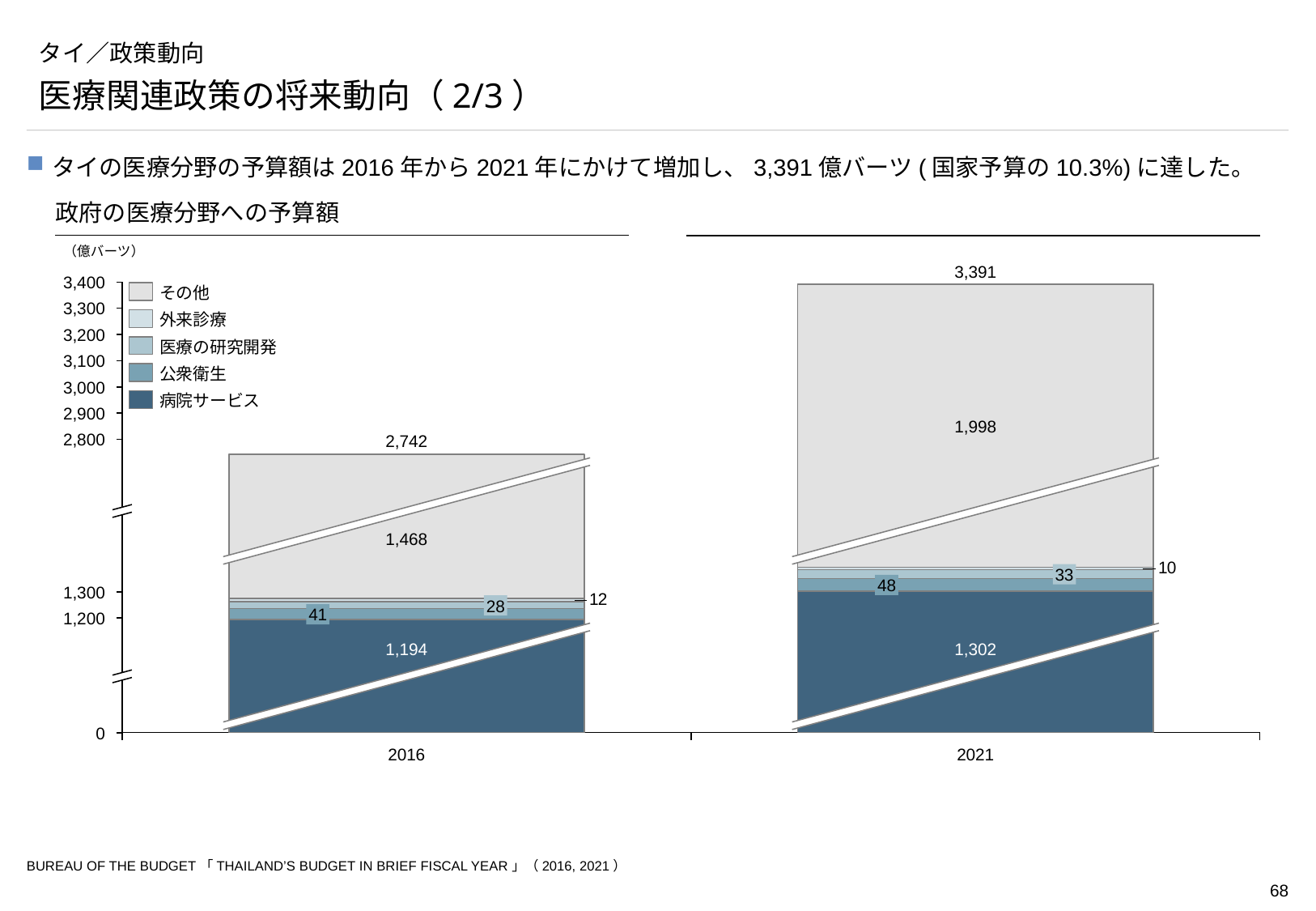
What kind of chart is shown on the slide? Stacked bar chart How many series does the legend list? 5 What is the difference between the 病院サービス values for 2021 and 2016? 108 Which year has the larger value for その他, 2016 or 2021? 2021 What is the value of 外来診療 in 2016? 12 What is the total value of the 2021 bar? 3,391 What is the value of 病院サービス in 2016? 1,194 What is the value of その他 in 2021? 1,998 What is the value of 公衆衛生 in 2021? 48 What unit is shown for the chart's values? 億バーツ What is the value of 医療の研究開発 in 2021? 33 What is the total value of the 2016 bar? 2,742